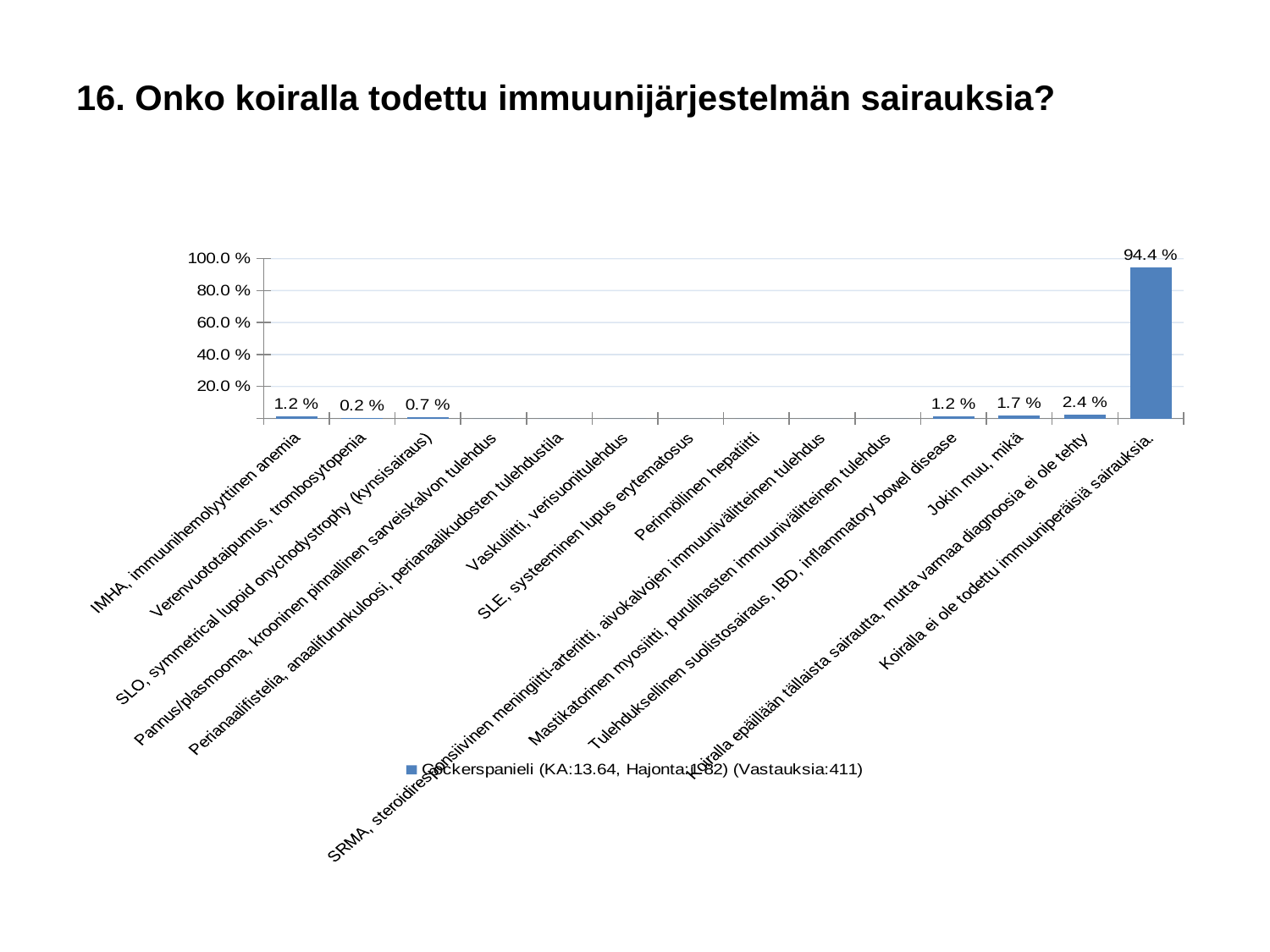
Which is larger: the value for "Jokin muu, mikä" or the value for "Tulehduksellinen suolistosairaus, IBD, inflammatory bowel disease"? Jokin muu, mikä Which category has the highest value? Koiralla ei ole todettu immuuniperäisiä sairauksia. How many series does the legend list? 1 What is the value for "Koiralla epäillään tällaista sairautta, mutta varmaa diagnoosia ei ole tehty"? 2.4 % What is the value for "Jokin muu, mikä"? 1.7 % What is the value for "Koiralla ei ole todettu immuuniperäisiä sairauksia."? 94.4 % Is the value for "Koiralla ei ole todettu immuuniperäisiä sairauksia." greater or less than 80.0 %? greater What is the difference between the values for "Koiralla ei ole todettu immuuniperäisiä sairauksia." and "Koiralla epäillään tällaista sairautta, mutta varmaa diagnoosia ei ole tehty"? 92.0 % What kind of chart is shown on the slide? bar chart What is the value for "SLO, symmetrical lupoid onychodystrophy (kynsisairaus)"? 0.7 % What is the value for "Verenvuototaipumus, trombosytopenia"? 0.2 % How many categories are shown on the x axis? 14